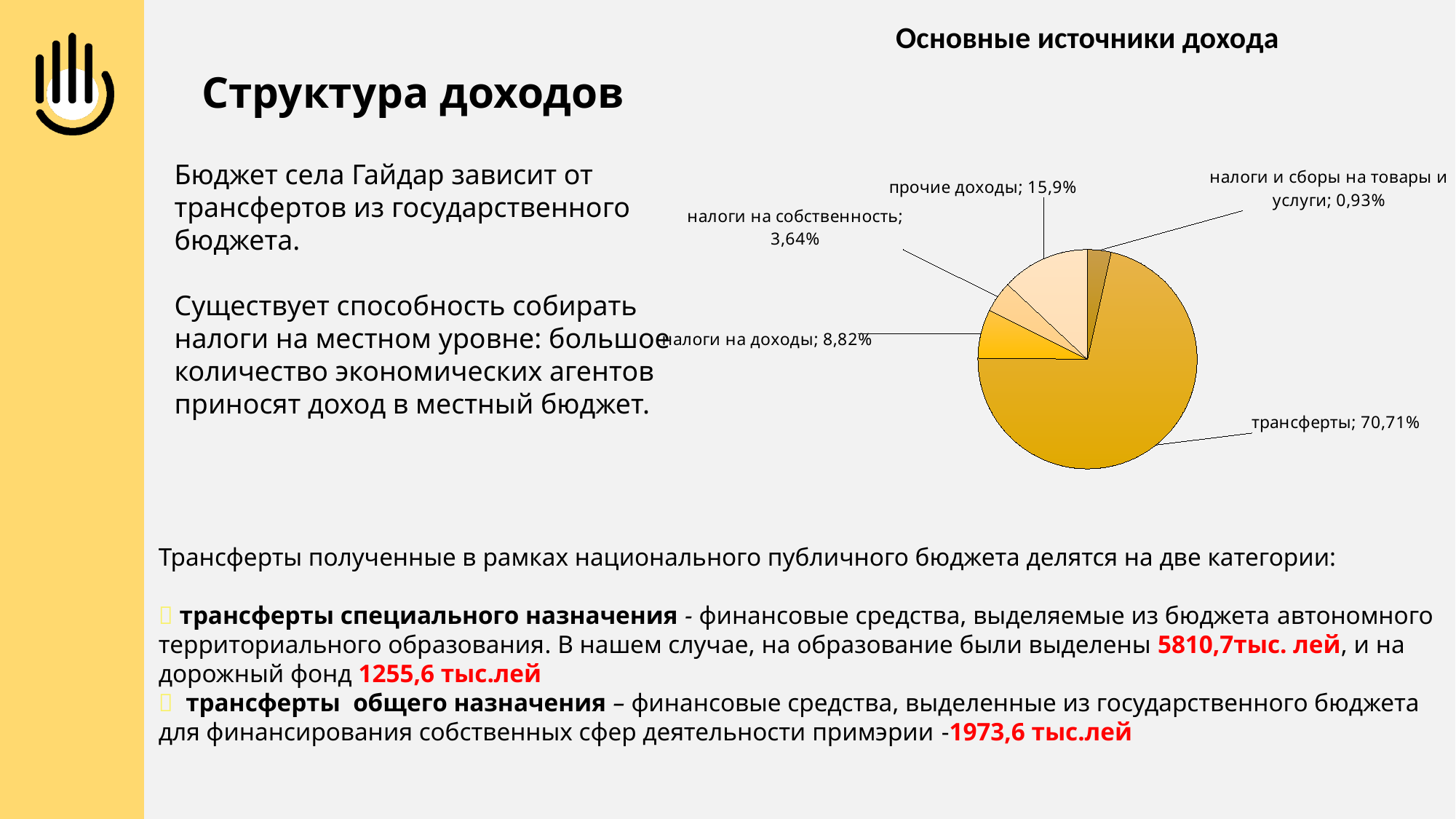
Which category has the largest share of the pie? трансферты What is the title of the chart? Основные источники дохода What share of the pie is labelled "трансферты"? 70,71% What is the value shown for "прочие доходы"? 15,9% What is the value shown for "налоги и сборы на товары и услуги"? 0,93% Which category has the smallest share of the pie? налоги и сборы на товары и услуги What is the difference between the shares of "трансферты" and "прочие доходы"? 54,81% What is the value shown for "налоги на доходы"? 8,82% Which is larger: the share of "налоги на доходы" or "налоги на собственность"? налоги на доходы How many slices does the pie chart have? 5 What kind of chart is shown on the slide? pie chart What is the value shown for "налоги на собственность"? 3,64%